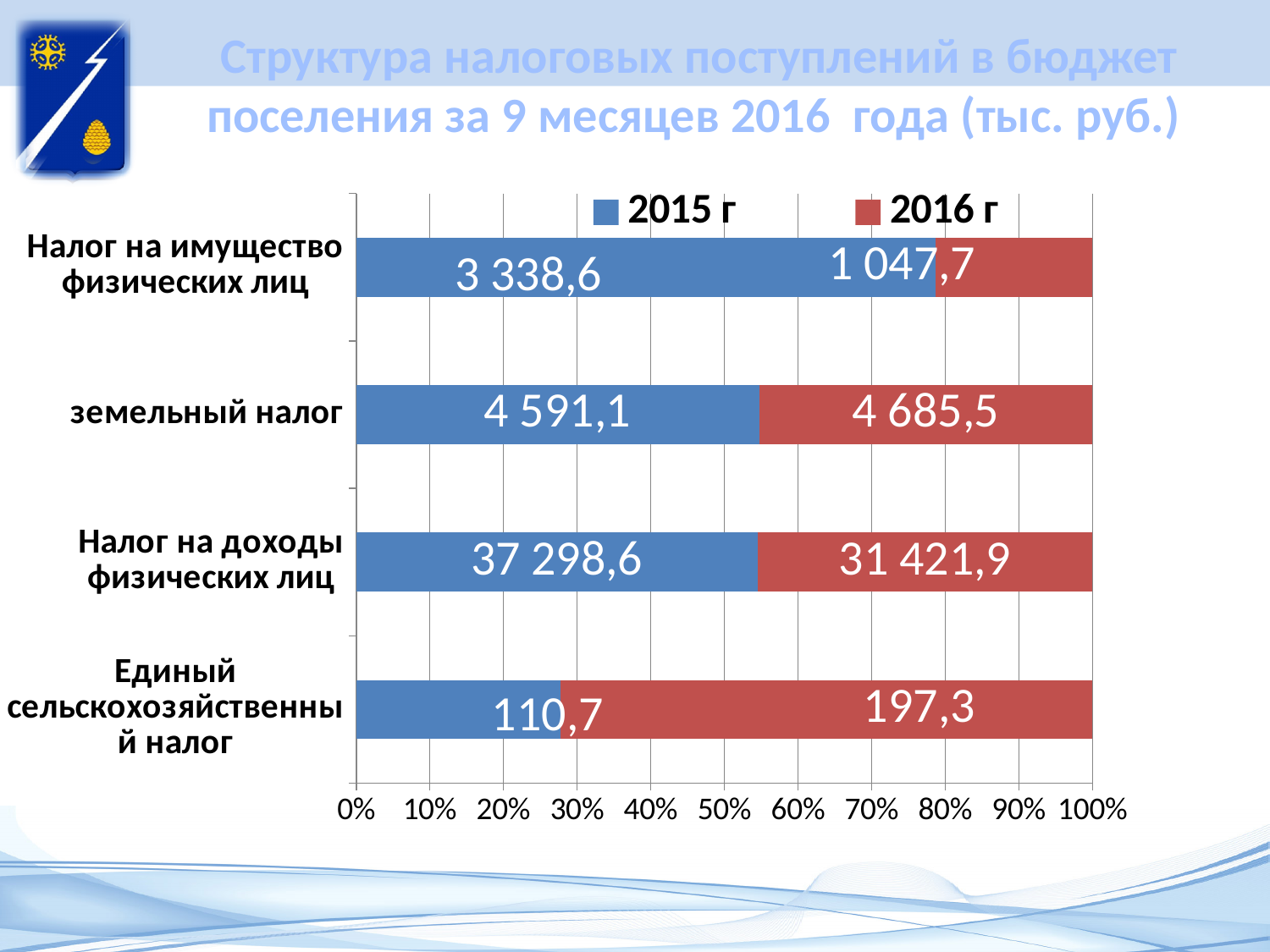
What is the 2015 г value for Налог на доходы физических лиц? 37 298,6 For земельный налог, which is larger: the 2015 г value or the 2016 г value? 2016 г Is the 2015 г share of the bar for Налог на имущество физических лиц greater or less than 70%? greater How many series does the legend list? 2 Which category has the lowest 2015 г value? Единый сельскохозяйственный налог What is the 2016 г value for Налог на имущество физических лиц? 1 047,7 What kind of chart is shown on the slide? bar chart What is the 2016 г value for земельный налог? 4 685,5 What is the difference between the 2015 г and 2016 г values for Налог на доходы физических лиц? 5 876,7 What is the 2015 г value for Единый сельскохозяйственный налог? 110,7 How many tax categories are shown on the chart? 4 Which category has the highest 2016 г value? Налог на доходы физических лиц